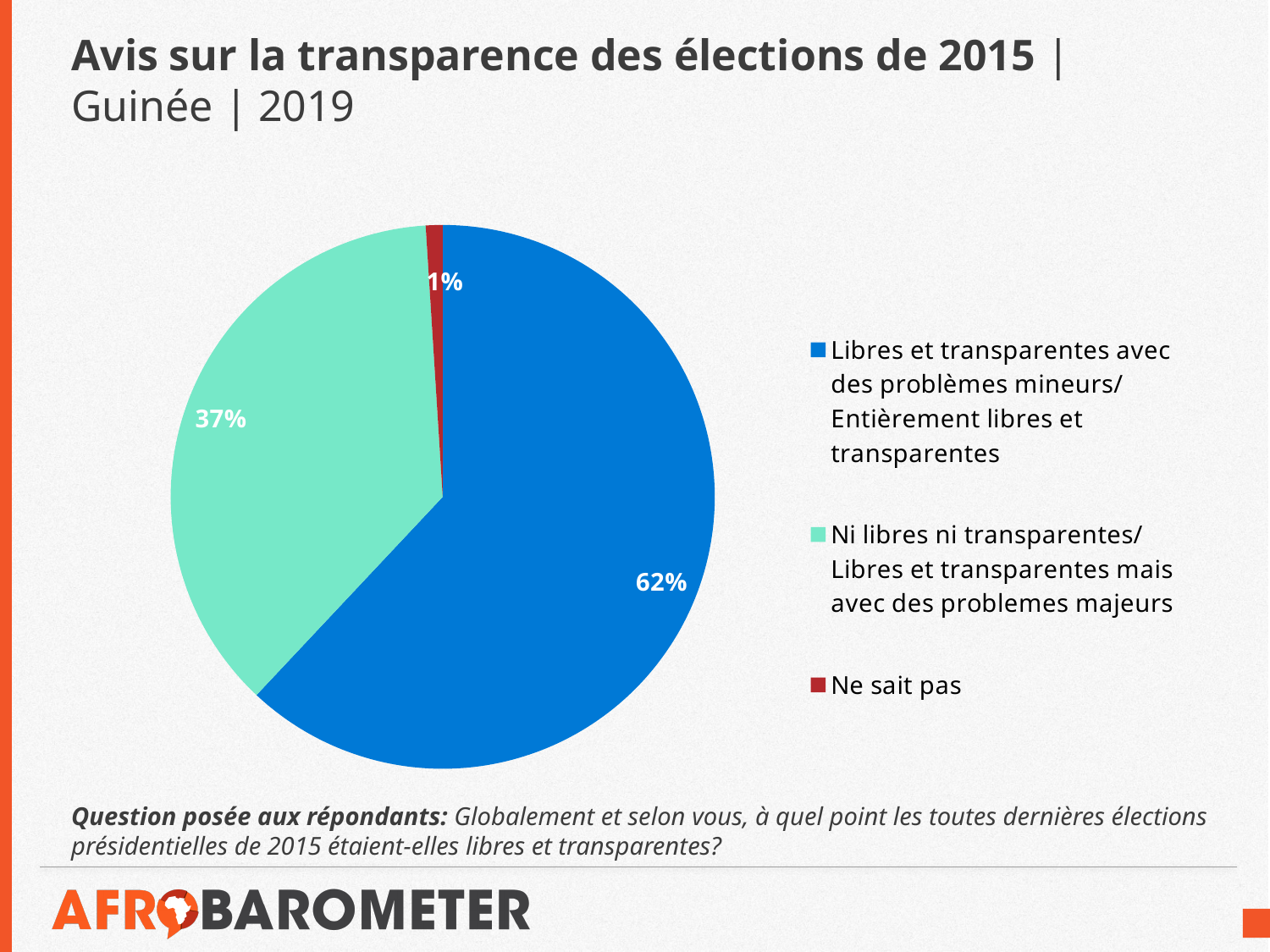
Which category has the largest slice of the pie? Libres et transparentes avec des problèmes mineurs/ Entièrement libres et transparentes What is the title of the slide? Avis sur la transparence des élections de 2015 | Guinée | 2019 What share of respondents said the elections were 'Libres et transparentes avec des problèmes mineurs/ Entièrement libres et transparentes'? 62% What share of respondents said the elections were 'Ni libres ni transparentes/ Libres et transparentes mais avec des problemes majeurs'? 37% How many entries does the legend list? 3 Which is larger: the share for 'Ni libres ni transparentes/ Libres et transparentes mais avec des problemes majeurs' or the share for 'Ne sait pas'? Ni libres ni transparentes/ Libres et transparentes mais avec des problemes majeurs Which category has the smallest slice of the pie? Ne sait pas What colour is the slice for 'Ne sait pas'? dark red What share of respondents answered 'Ne sait pas'? 1% What is the difference in percentage points between the 62% slice and the 37% slice? 25 percentage points What kind of chart is shown on the slide? pie chart How many slices does the pie chart have? 3